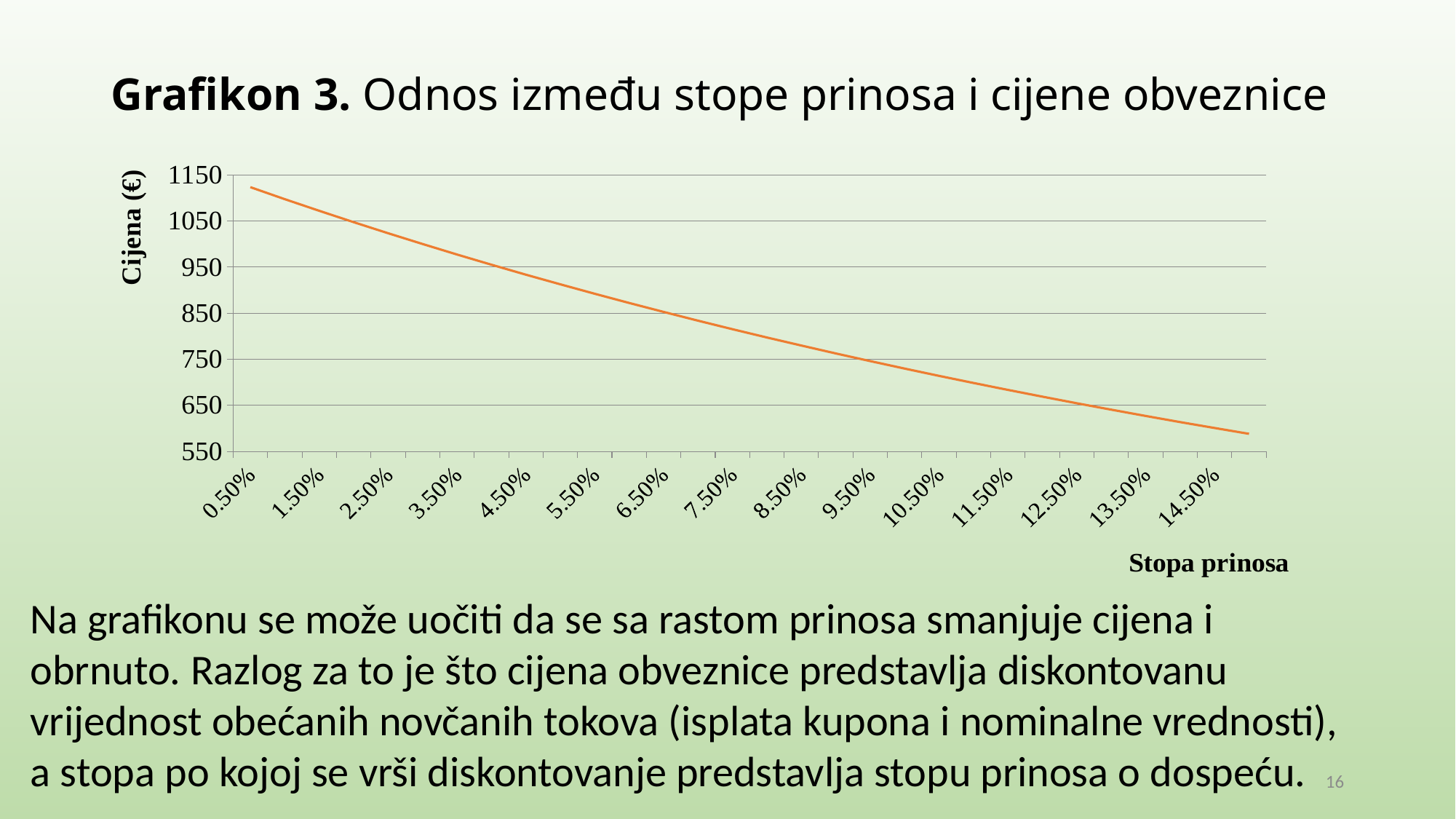
At which yield rate shown on the x axis is the price (Cijena) highest? 0.50% Is the price at a yield of 2.50% greater or less than 950? greater Is the price at a yield of 11.50% greater or less than 750? less How many yield rate labels are shown on the x axis? 15 Is the price at a yield of 0.50% greater or less than 1050? greater What is the label of the vertical axis? Cijena (€) What kind of chart is shown on the slide? line chart Which is larger, the price at a yield of 4.50% or the price at a yield of 9.50%? 4.50% What is the label of the horizontal axis? Stopa prinosa Does the bond price rise or fall as the yield rate (Stopa prinosa) increases along the x axis? fall